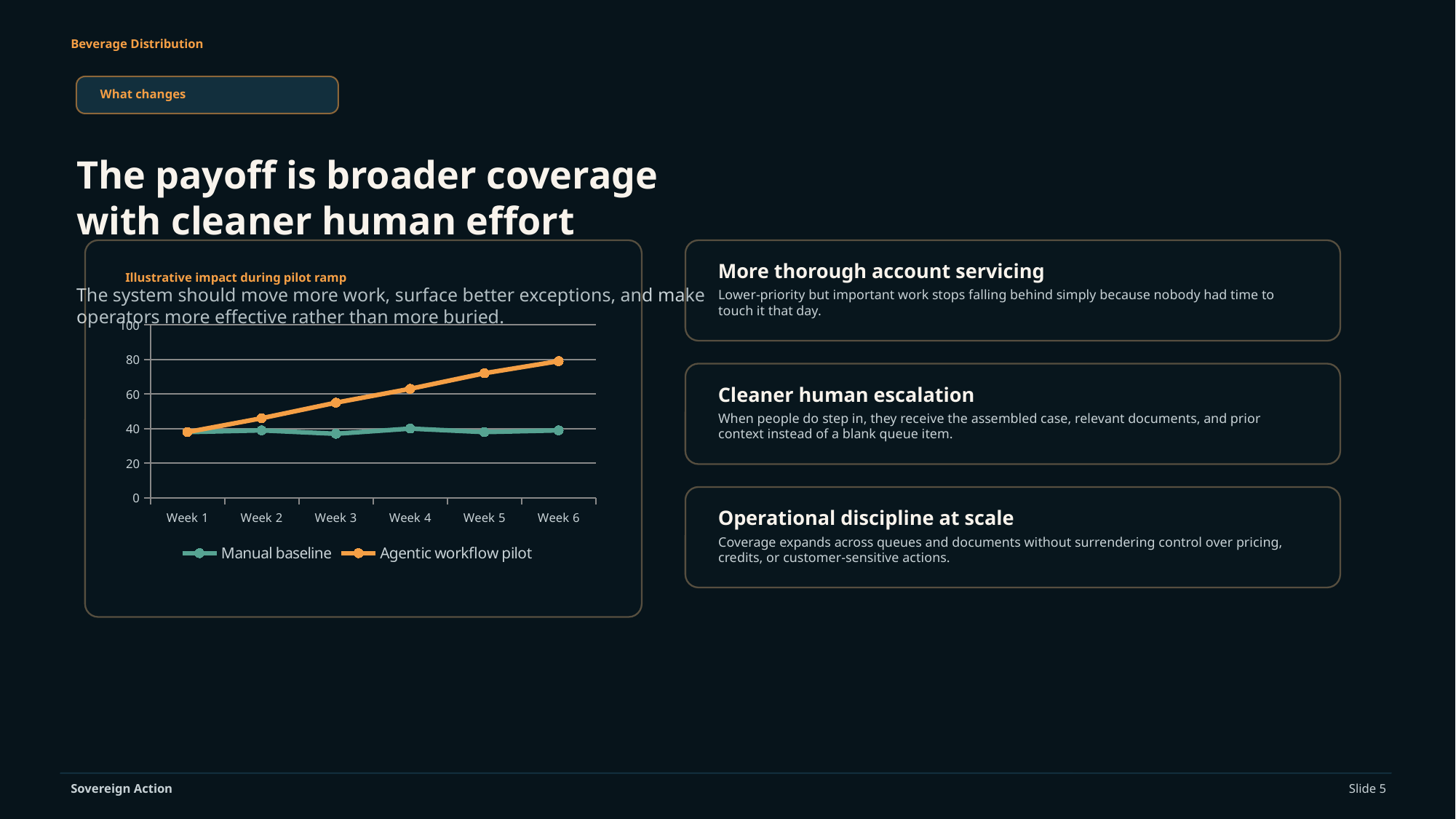
Is the Manual baseline value at Week 4 greater or less than 60? less How many weeks are plotted along the x axis of the chart? 6 At Week 6, which series has the larger value, Manual baseline or Agentic workflow pilot? Agentic workflow pilot In which week is the Agentic workflow pilot value lowest? Week 1 How many series does the chart legend list? 2 What kind of chart is shown on the slide? line chart What is the title of the chart? Illustrative impact during pilot ramp Which series is drawn in orange in the chart? Agentic workflow pilot Is the Agentic workflow pilot value at Week 3 greater or less than 40? greater Is the Agentic workflow pilot value at Week 6 greater or less than 60? greater In which week is the Agentic workflow pilot value highest? Week 6 Does the Agentic workflow pilot series rise or fall from Week 1 to Week 6? rise